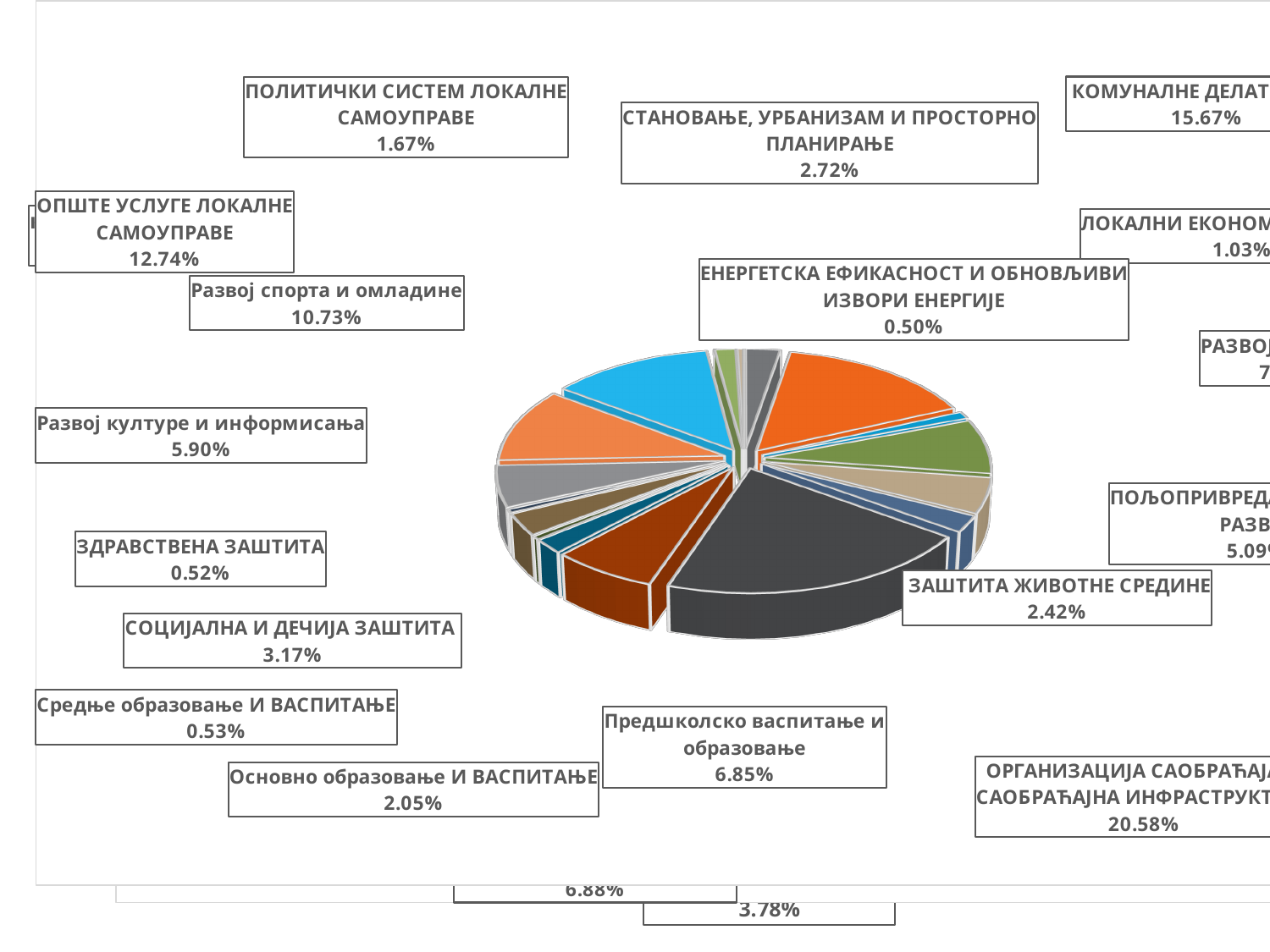
What percentage is shown for Развој спорта и омладине? 10.73% What is the largest percentage printed on the pie chart? 20.58% Which fully labelled category has the smallest share in the pie chart? ЕНЕРГЕТСКА ЕФИКАСНОСТ И ОБНОВЉИВИ ИЗВОРИ ЕНЕРГИЈЕ What share does ОПШТЕ УСЛУГЕ ЛОКАЛНЕ САМОУПРАВЕ have in the pie chart? 12.74% What is the difference between the shares of ОПШТЕ УСЛУГЕ ЛОКАЛНЕ САМОУПРАВЕ and Развој спорта и омладине? 2.01% What percentage is labelled for ЕНЕРГЕТСКА ЕФИКАСНОСТ И ОБНОВЉИВИ ИЗВОРИ ЕНЕРГИЈЕ? 0.50% Which has a larger share, Основно образовање И ВАСПИТАЊЕ or СТАНОВАЊЕ, УРБАНИЗАМ И ПРОСТОРНО ПЛАНИРАЊЕ? СТАНОВАЊЕ, УРБАНИЗАМ И ПРОСТОРНО ПЛАНИРАЊЕ What share is shown for Предшколско васпитање и образовање? 6.85% Which has a larger share, Развој културе и информисања or Предшколско васпитање и образовање? Предшколско васпитање и образовање What is the value labelled for ЗАШТИТА ЖИВОТНЕ СРЕДИНЕ? 2.42% What is the value shown for СОЦИЈАЛНА И ДЕЧИЈА ЗАШТИТА? 3.17% What kind of chart is shown on the slide? pie chart